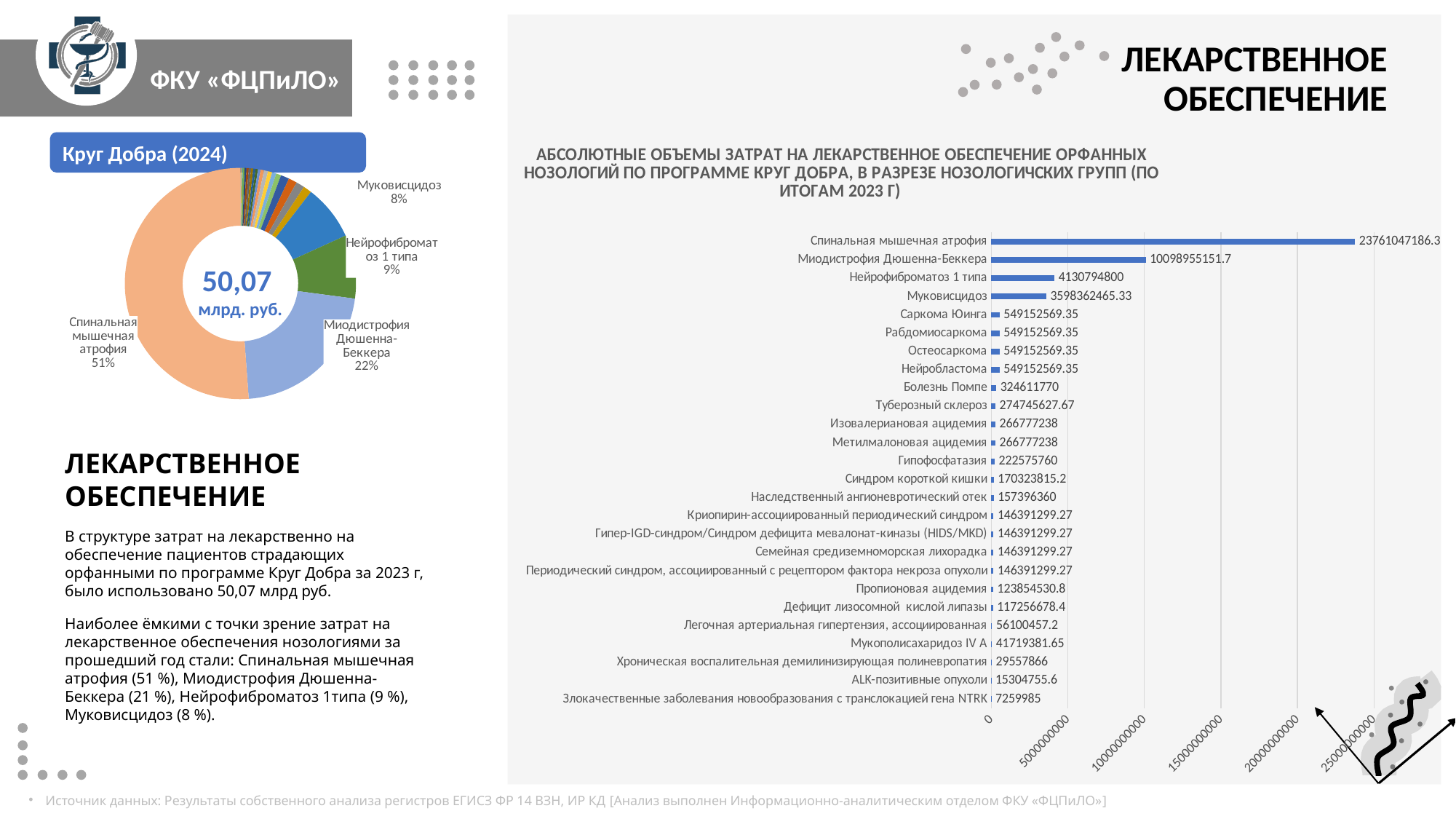
On the bar chart on the right, which is larger: Нейрофиброматоз 1 типа or Муковисцидоз? Нейрофиброматоз 1 типа On the bar chart on the right, what is the value for Болезнь Помпе? 324611770 On the bar chart on the right, which category has the highest value? Спинальная мышечная атрофия On the 'Круг Добра (2024)' donut chart, what share does Миодистрофия Дюшенна-Беккера have? 22% On the 'Круг Добра (2024)' donut chart, what share does Спинальная мышечная атрофия have? 51% On the bar chart on the right, which category has the lowest value? Злокачественные заболевания новообразования с транслокацией гена NTRK What kind of chart is the chart on the right side of the slide? Bar chart On the bar chart on the right, what is the value for Муковисцидоз? 3598362465.33 On the bar chart on the right, what is the difference between Нейрофиброматоз 1 типа and Муковисцидоз? 532432334.67 On the bar chart on the right, what is the value for Спинальная мышечная атрофия? 23761047186.3 On the bar chart on the right, how many categories are plotted? 26 What value is shown in the centre of the 'Круг Добра (2024)' donut chart? 50,07 млрд. руб.